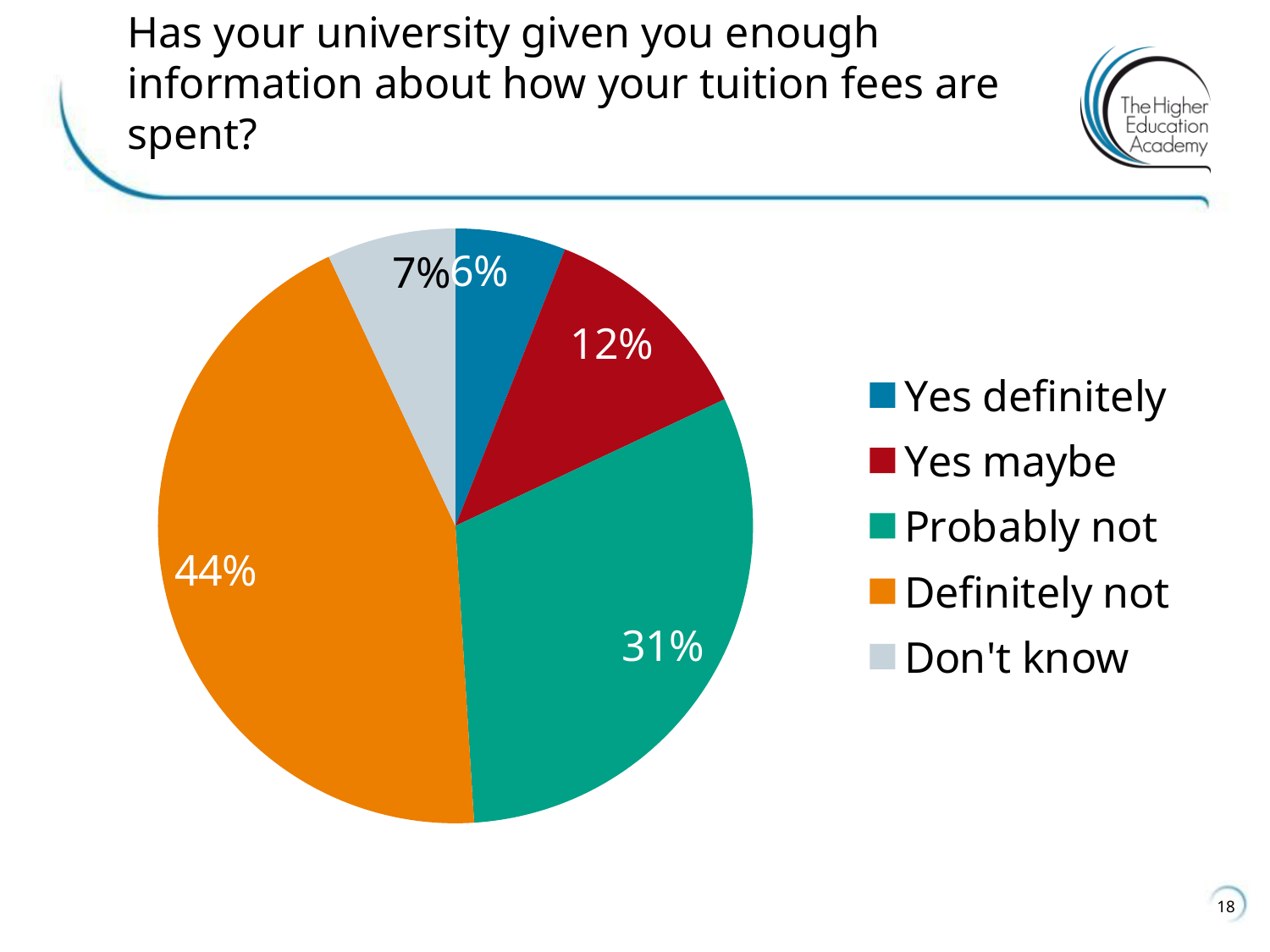
What is the difference in percentage points between "Definitely not" and "Probably not"? 13 What kind of chart is shown on the slide? Pie chart What percentage of respondents answered "Yes maybe"? 12% Which response has the largest share of the pie? Definitely not Which is larger, the share for "Yes maybe" or the share for "Don't know"? Yes maybe Which response has the smallest share of the pie? Yes definitely What percentage of respondents answered "Don't know"? 7% What percentage of respondents answered "Definitely not"? 44% How many categories does the legend list? 5 What colour is the slice for "Probably not"? Green What percentage of respondents answered "Probably not"? 31% What percentage of respondents answered "Yes definitely"? 6%